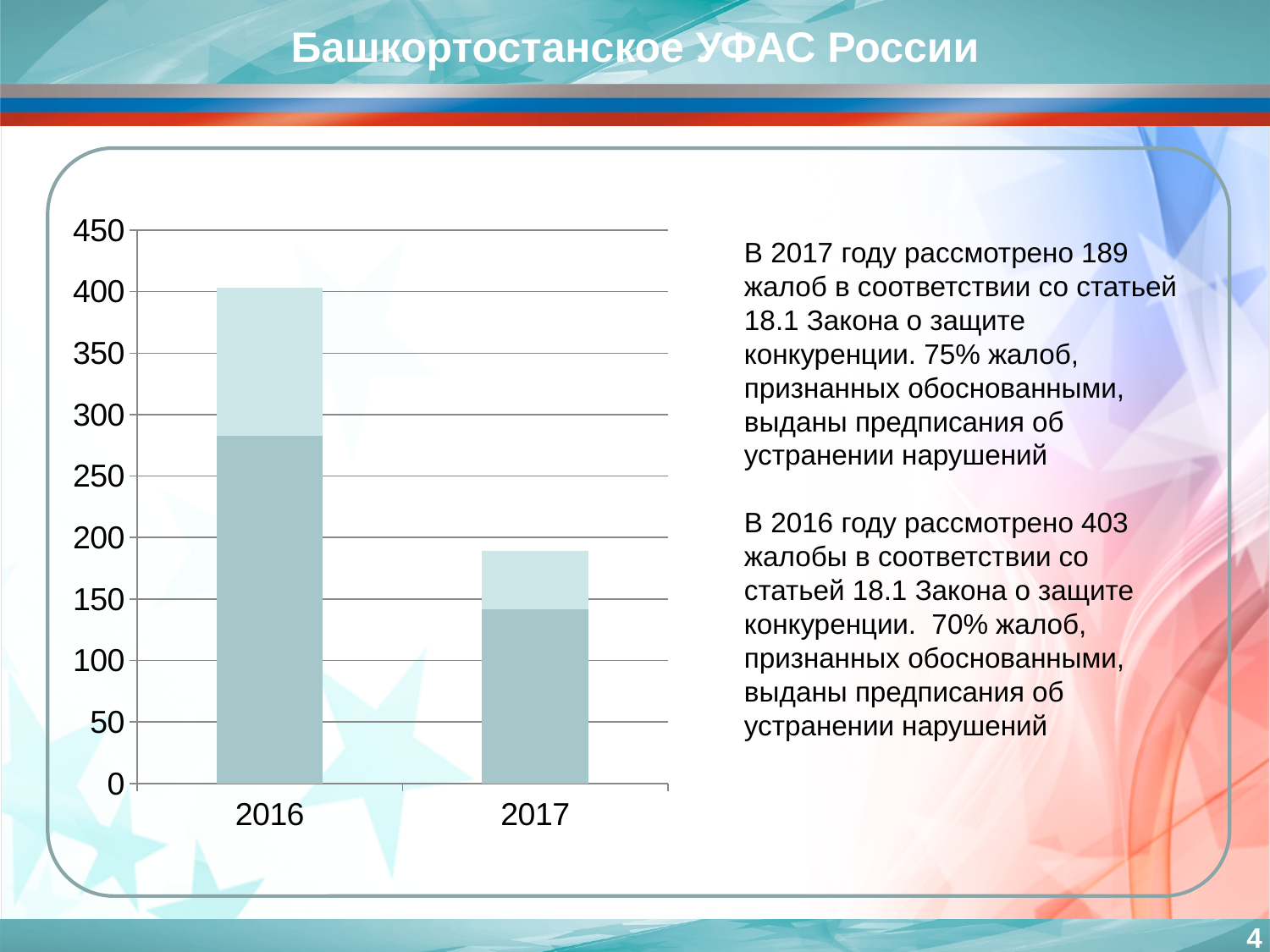
What kind of chart is shown on the slide? bar chart Is the total value of the 2017 bar greater or less than 250? less Is the total value of the 2016 bar greater or less than 350? greater Do the bar totals rise or fall from 2016 to 2017? fall Is the lower (darker) segment of the 2016 bar greater or less than 250? greater Is the total bar for 2016 larger or smaller than the total bar for 2017? larger How many categories are shown on the x axis of the chart? 2 Which year has the taller bar in the chart? 2016 Which year has the shorter bar in the chart? 2017 What is the highest value shown on the vertical axis of the chart? 450